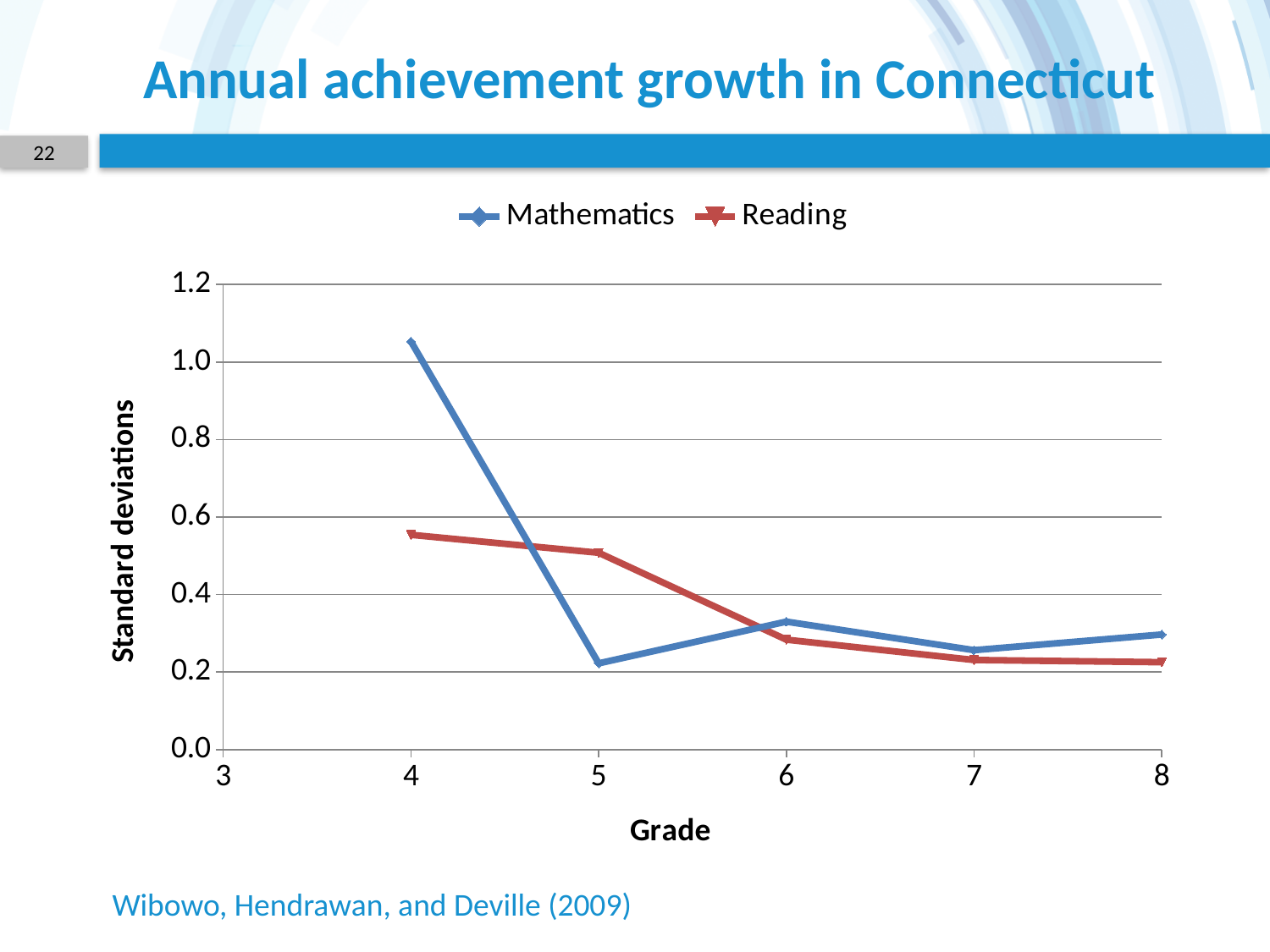
At grade 5, which series has the larger value, Mathematics or Reading? Reading How many grades have data points plotted for the Mathematics series? 5 At which grade is the Mathematics value highest? 4 Which two series are listed in the legend? Mathematics and Reading At grade 4, which series has the larger value, Mathematics or Reading? Mathematics What kind of chart is shown on the slide? line chart At which grade is the Mathematics value lowest? 5 What is the label of the vertical axis? Standard deviations Does the Reading series generally rise or fall from grade 4 to grade 8? fall At which grade is the Reading value highest? 4 Is the Mathematics value at grade 4 greater or less than 1.0? greater How many series does the legend list? 2